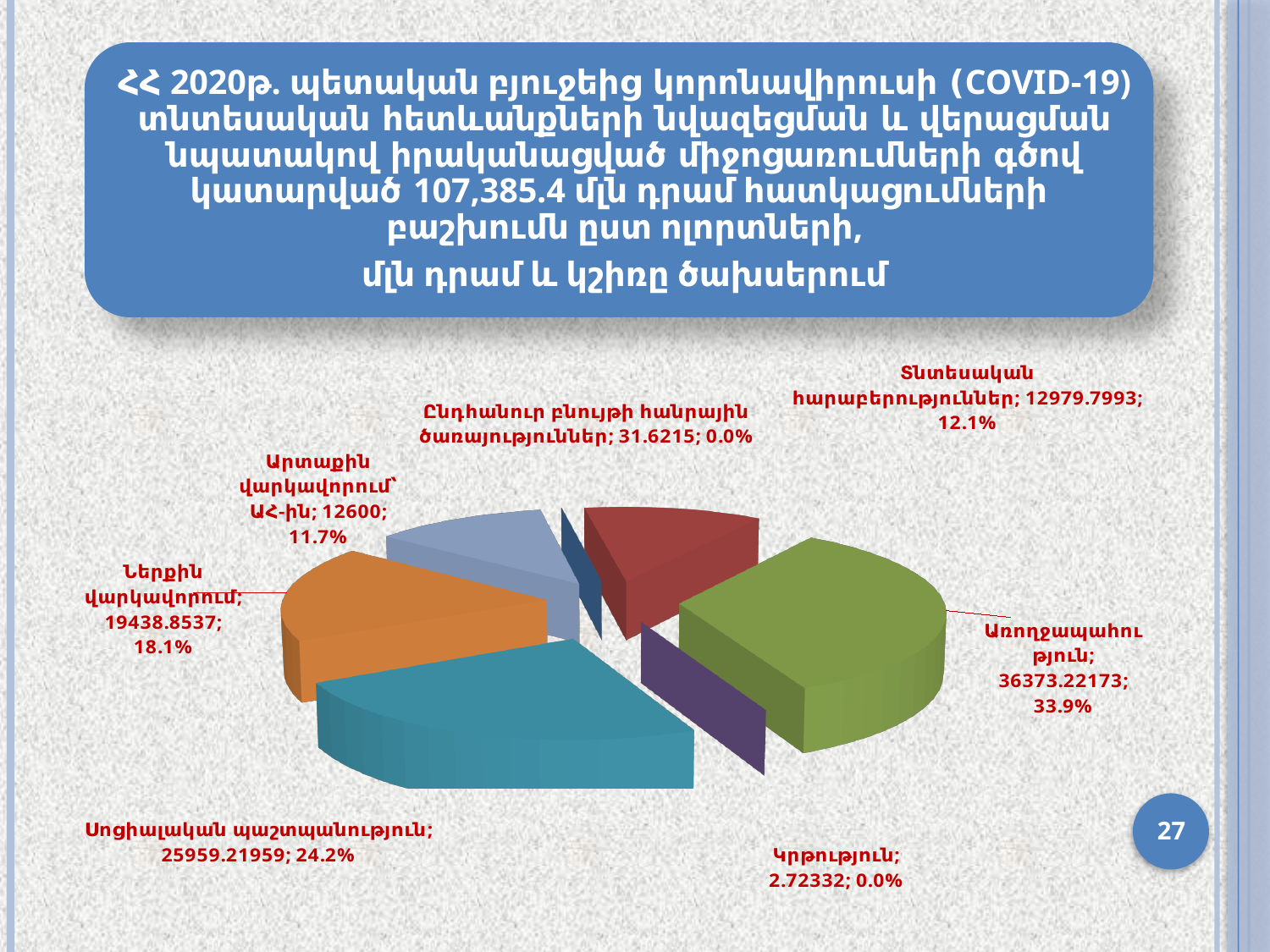
Which category has the largest share of the pie? Առողջապահություն Which category has the smallest value in the pie chart? Կրթություն What is the value shown for Սոցիալական պաշտպանություն? 25959.21959 What is the value shown for Ընդհանուր բնույթի հանրային ծառայություններ? 31.6215 What share of the pie does Առողջապահություն represent? 33.9% How many slices (categories) does the pie chart have? 7 What percentage is shown for Տնտեսական հարաբերություններ? 12.1% Which is larger, the value for Սոցիալական պաշտպանություն or the value for Ներքին վարկավորում? Սոցիալական պաշտպանություն What is the value shown for Առողջապահություն? 36373.22173 What kind of chart is shown on the slide? pie chart What is the value shown for Արտաքին վարկավորում՝ ԱՀ-ին? 12600 What percentage is shown for Ներքին վարկավորում? 18.1%